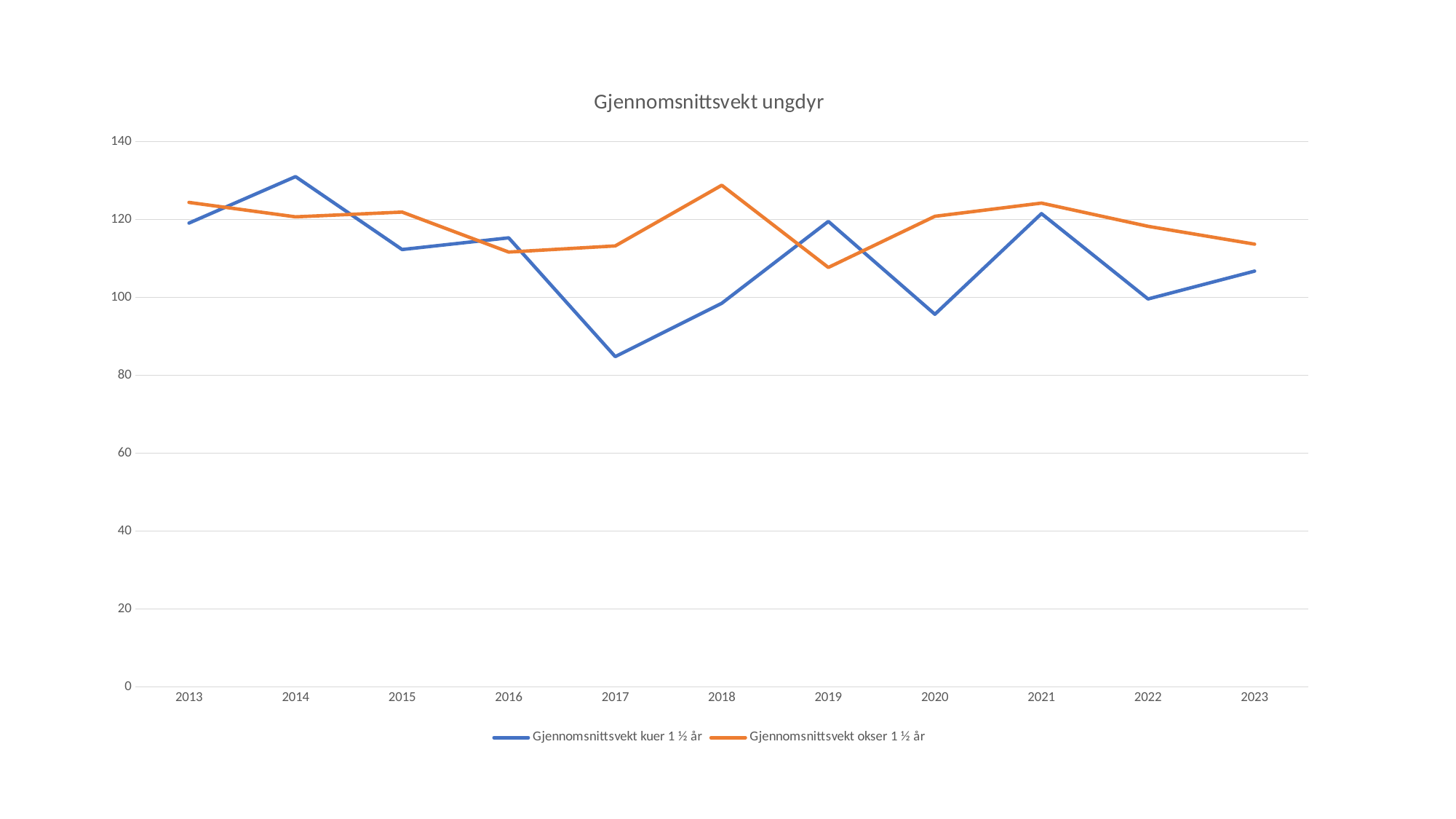
Is the value for Gjennomsnittsvekt okser 1 ½ år in 2018 greater or less than 120? greater What kind of chart is shown on the slide? line chart In which year is the value for Gjennomsnittsvekt kuer 1 ½ år lowest? 2017 How many series does the legend list? 2 How many years are plotted along the x axis? 11 In which year is the value for Gjennomsnittsvekt okser 1 ½ år lowest? 2019 Which colour is used for the Gjennomsnittsvekt okser 1 ½ år line? orange In which year is the value for Gjennomsnittsvekt okser 1 ½ år highest? 2018 In which year is the value for Gjennomsnittsvekt kuer 1 ½ år highest? 2014 What is the title of the chart? Gjennomsnittsvekt ungdyr Is the value for Gjennomsnittsvekt kuer 1 ½ år in 2017 greater or less than 100? less In 2017, which series has the larger value, Gjennomsnittsvekt kuer 1 ½ år or Gjennomsnittsvekt okser 1 ½ år? Gjennomsnittsvekt okser 1 ½ år